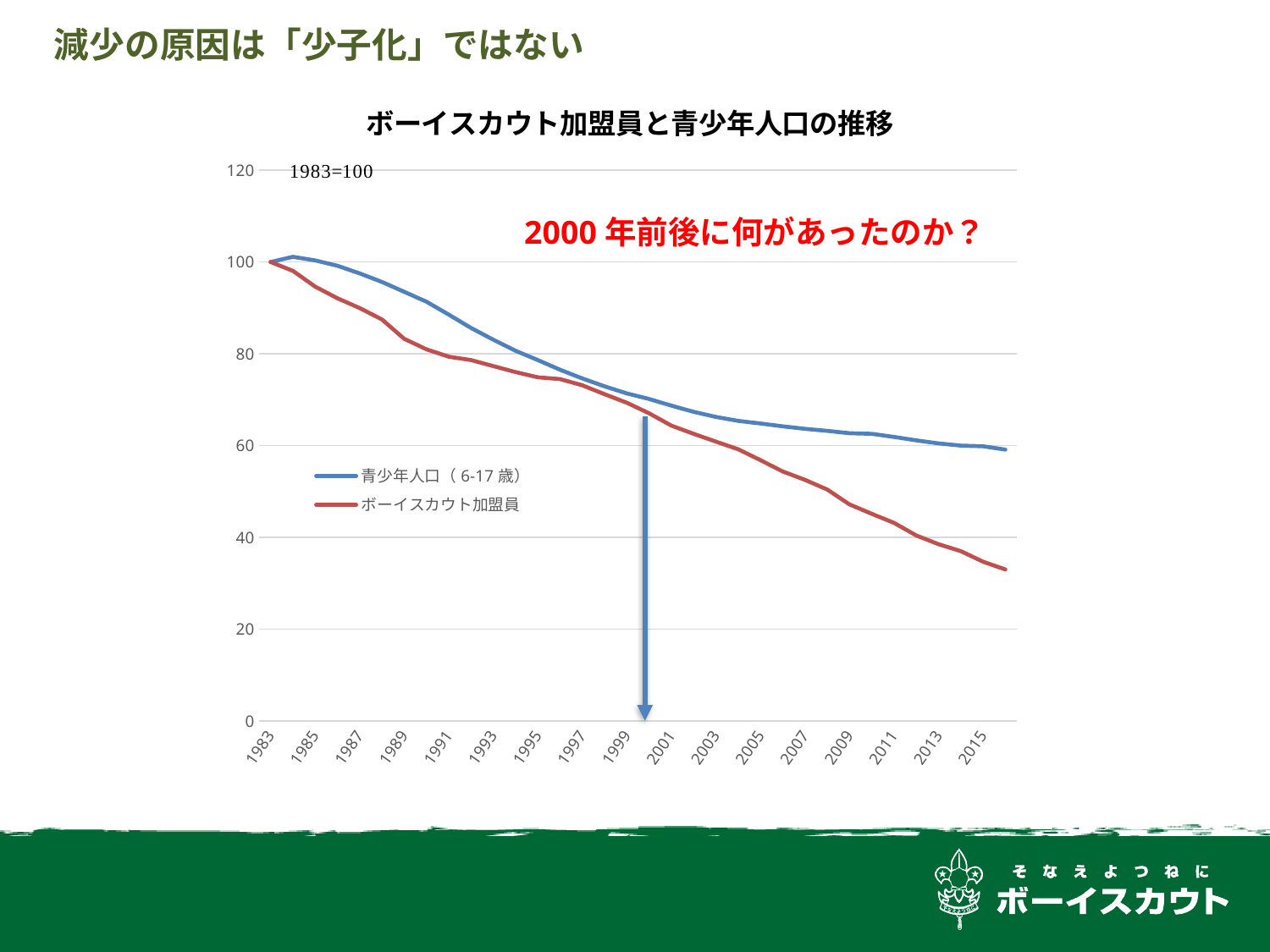
Do the values for ボーイスカウト加盟員 rise or fall from 1983 to 2015? fall Which year is used as the base year (index = 100) in the chart? 1983 In 2015, which series has the larger value, 青少年人口（6-17歳） or ボーイスカウト加盟員? 青少年人口（6-17歳） Do the values for 青少年人口（6-17歳） rise or fall along the x axis? fall What is the title of the chart? ボーイスカウト加盟員と青少年人口の推移 What kind of chart is shown on the slide? line chart Is the value for 青少年人口（6-17歳） in 2009 greater or less than 60? greater How many series does the legend list? 2 How many year labels are shown on the x axis? 17 What is the value of ボーイスカウト加盟員 in 1983? 100 Is the value for ボーイスカウト加盟員 in 2015 greater or less than 40? less Is the value for 青少年人口（6-17歳） in 1991 greater or less than 80? greater